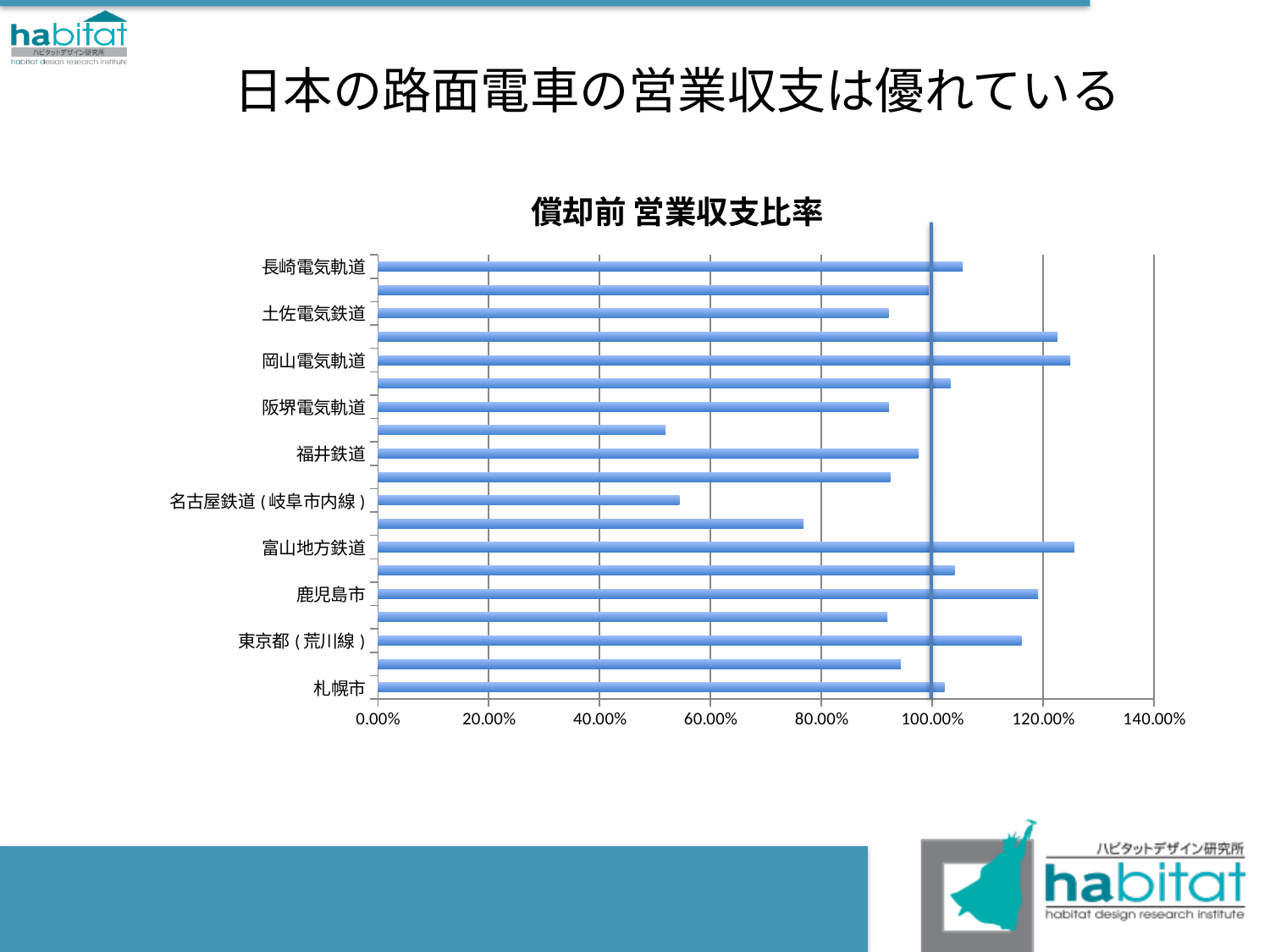
What is the title of the chart? 償却前 営業収支比率 Which has the larger value, 岡山電気軌道 or 土佐電気鉄道? 岡山電気軌道 What is the highest value shown on the horizontal axis? 140.00% Is the value for 東京都(荒川線) greater or less than 100.00%? greater Which has the larger value, 鹿児島市 or 名古屋鉄道(岐阜市内線)? 鹿児島市 What kind of chart is shown on the slide? bar chart Is the value for 名古屋鉄道(岐阜市内線) greater or less than 60.00%? less Is the value for 長崎電気軌道 greater or less than 100.00%? greater